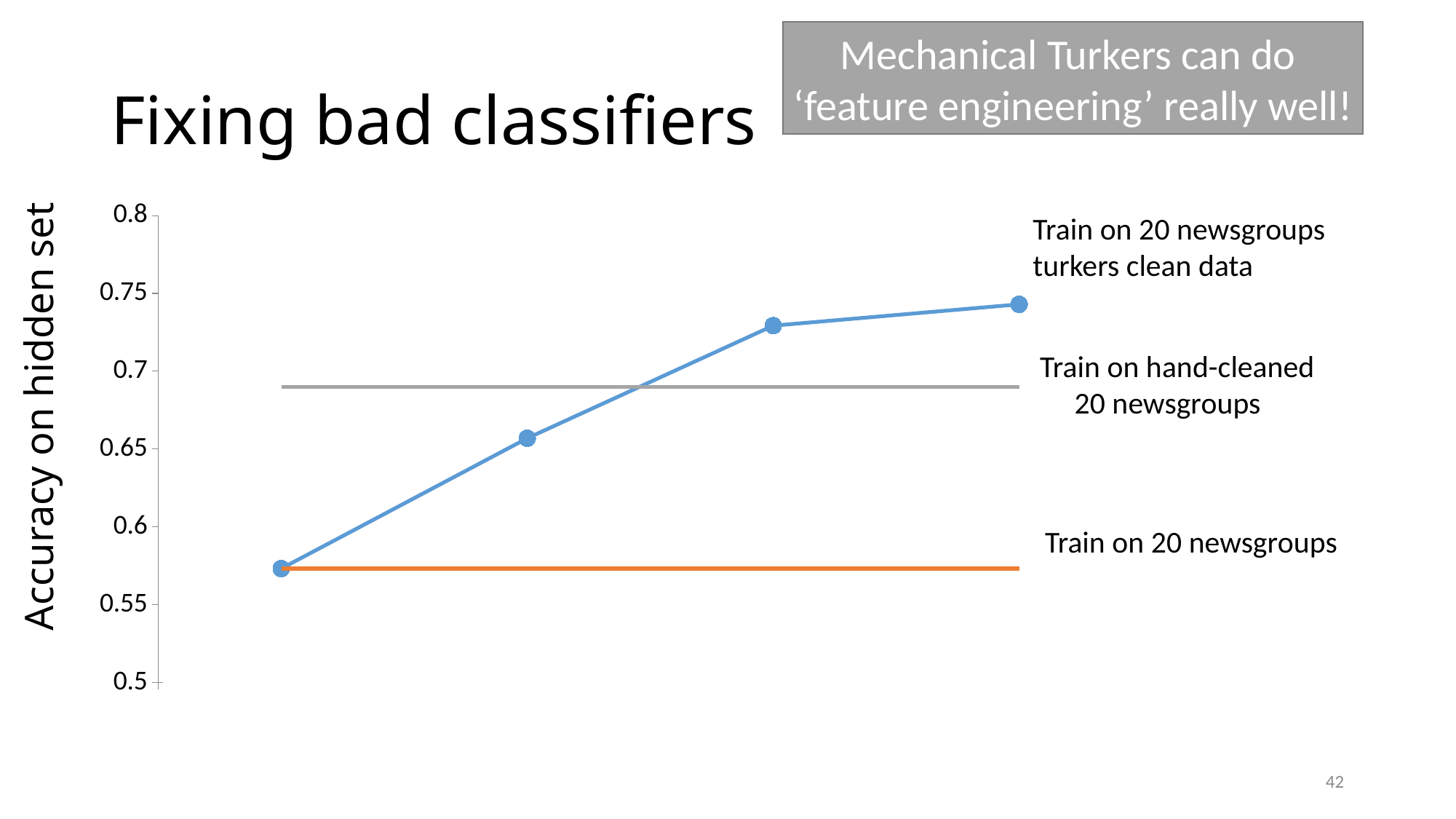
How many data points are marked on the blue 'Train on 20 newsgroups turkers clean data' line? 4 What kind of chart is shown on the slide? line chart How many lines are plotted on the chart? 3 Is the last point of the 'Train on 20 newsgroups turkers clean data' line greater or less than 0.7? greater What is the highest value shown on the vertical axis of the chart? 0.8 Is the value of the 'Train on 20 newsgroups' orange line greater or less than 0.6? less What is the label on the vertical axis of the chart? Accuracy on hidden set Is the first point of the 'Train on 20 newsgroups turkers clean data' line greater or less than 0.6? less At the right end of the chart, which is higher: the 'Train on 20 newsgroups turkers clean data' line or the 'Train on hand-cleaned 20 newsgroups' line? Train on 20 newsgroups turkers clean data Does the 'Train on 20 newsgroups turkers clean data' line rise or fall from left to right? rise Which line has the lowest accuracy on the chart? Train on 20 newsgroups